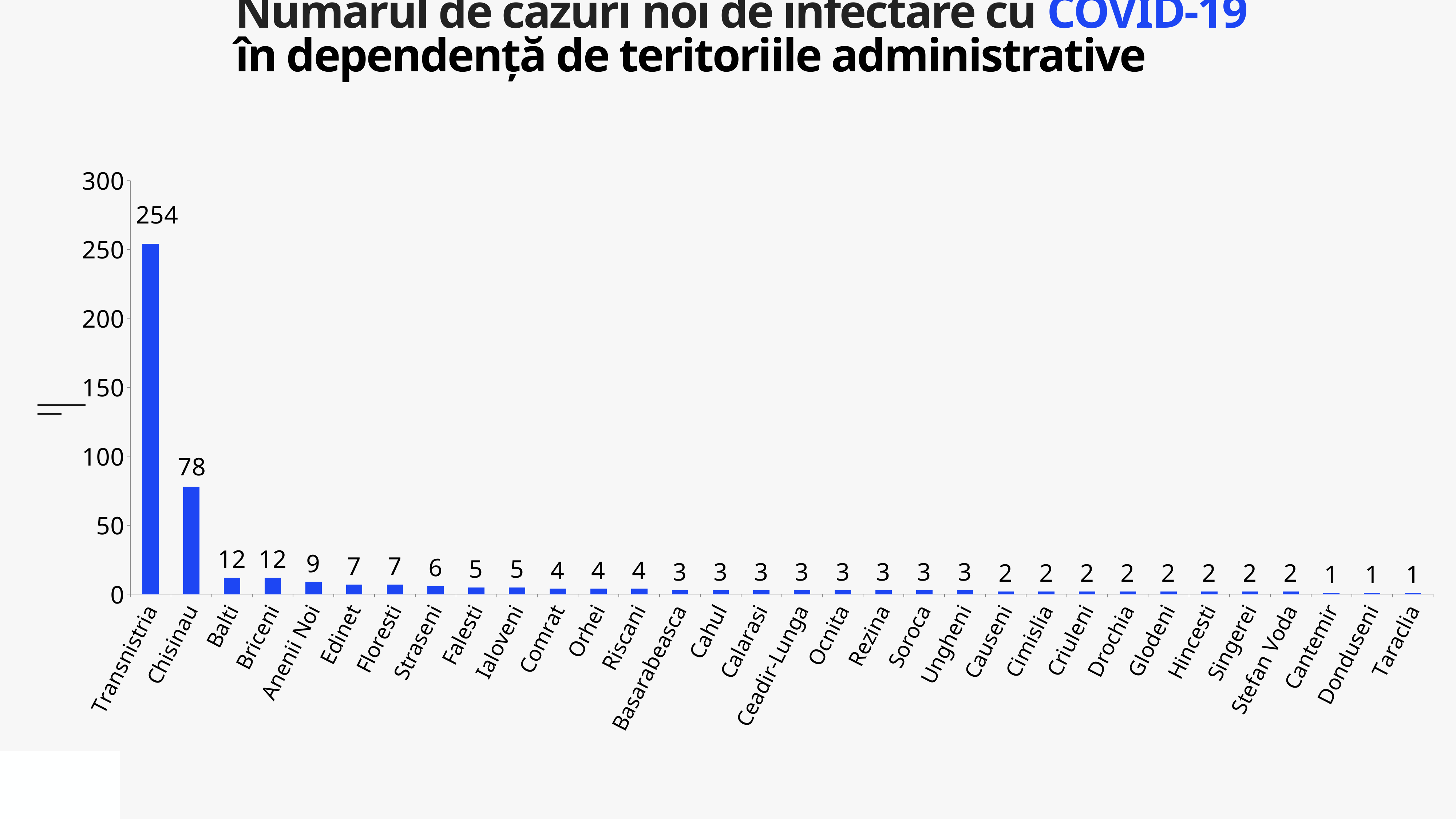
What is the value for Straseni? 6 What is the value for Anenii Noi? 9 Do the values rise or fall from left to right along the x axis? fall Which is larger, the value for Chisinau or the value for Balti? Chisinau Is the value for Transnistria greater or less than 200? greater What is the value for Transnistria? 254 What is the difference between the values for Balti and Edinet? 5 How many categories are shown on the x axis? 32 What kind of chart is shown on the slide? bar chart Which category has the highest value? Transnistria What is the value for Chisinau? 78 What is the difference between the values for Transnistria and Chisinau? 176